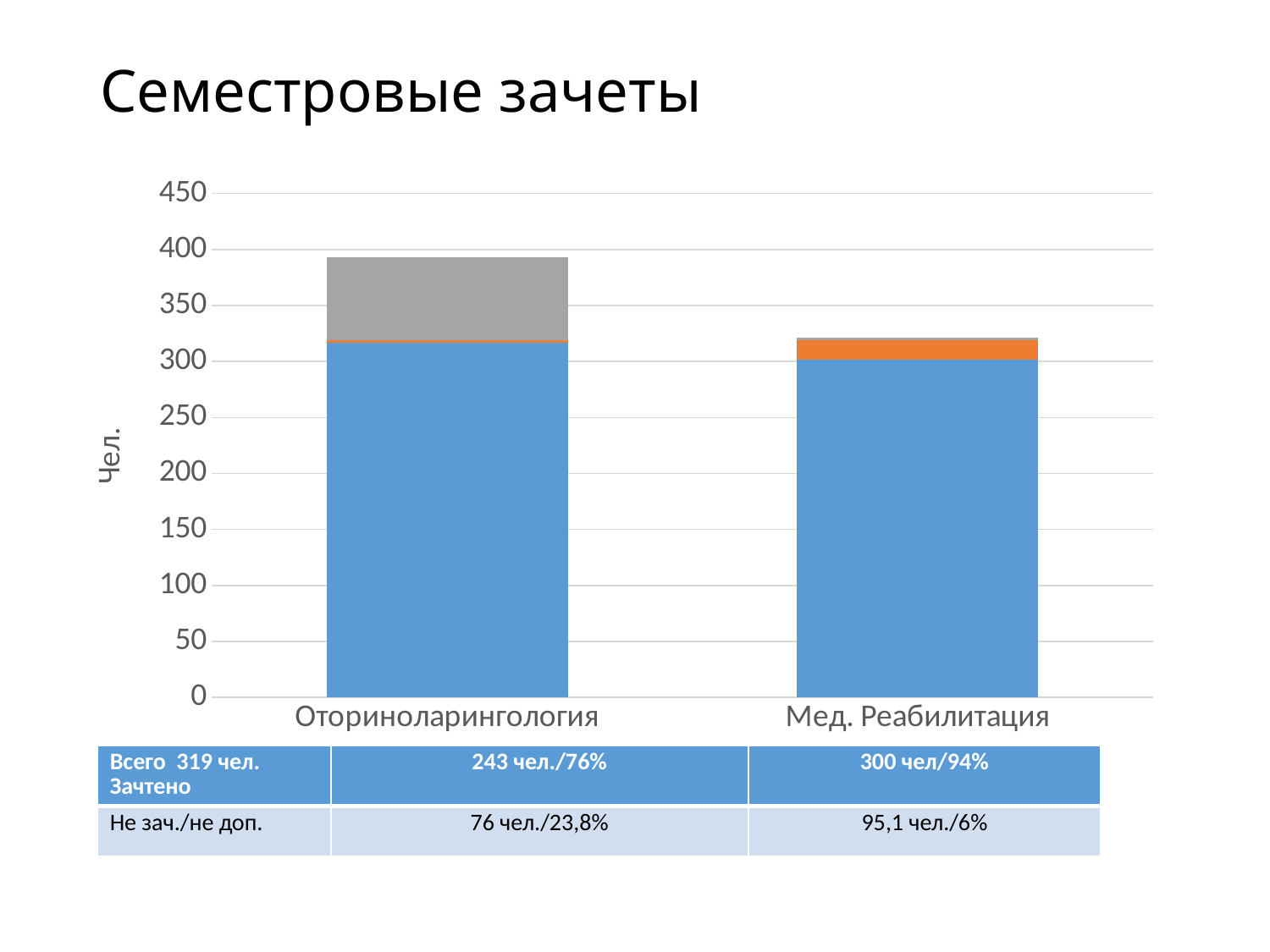
Which category has the taller stacked bar overall? Оториноларингология Which category has the shorter stacked bar overall? Мед. Реабилитация Which category has the larger orange segment in its bar? Мед. Реабилитация Which category has the larger grey segment in its bar? Оториноларингология What is the label on the vertical axis of the chart? Чел. What kind of chart is shown on the slide? bar chart Is the total height of the bar for Мед. Реабилитация greater or less than 300? greater Is the total height of the bar for Мед. Реабилитация greater or less than 350? less What is the title of the slide above the chart? Семестровые зачеты Is the total height of the bar for Оториноларингология greater or less than 400? less How many categories are shown on the x axis of the chart? 2